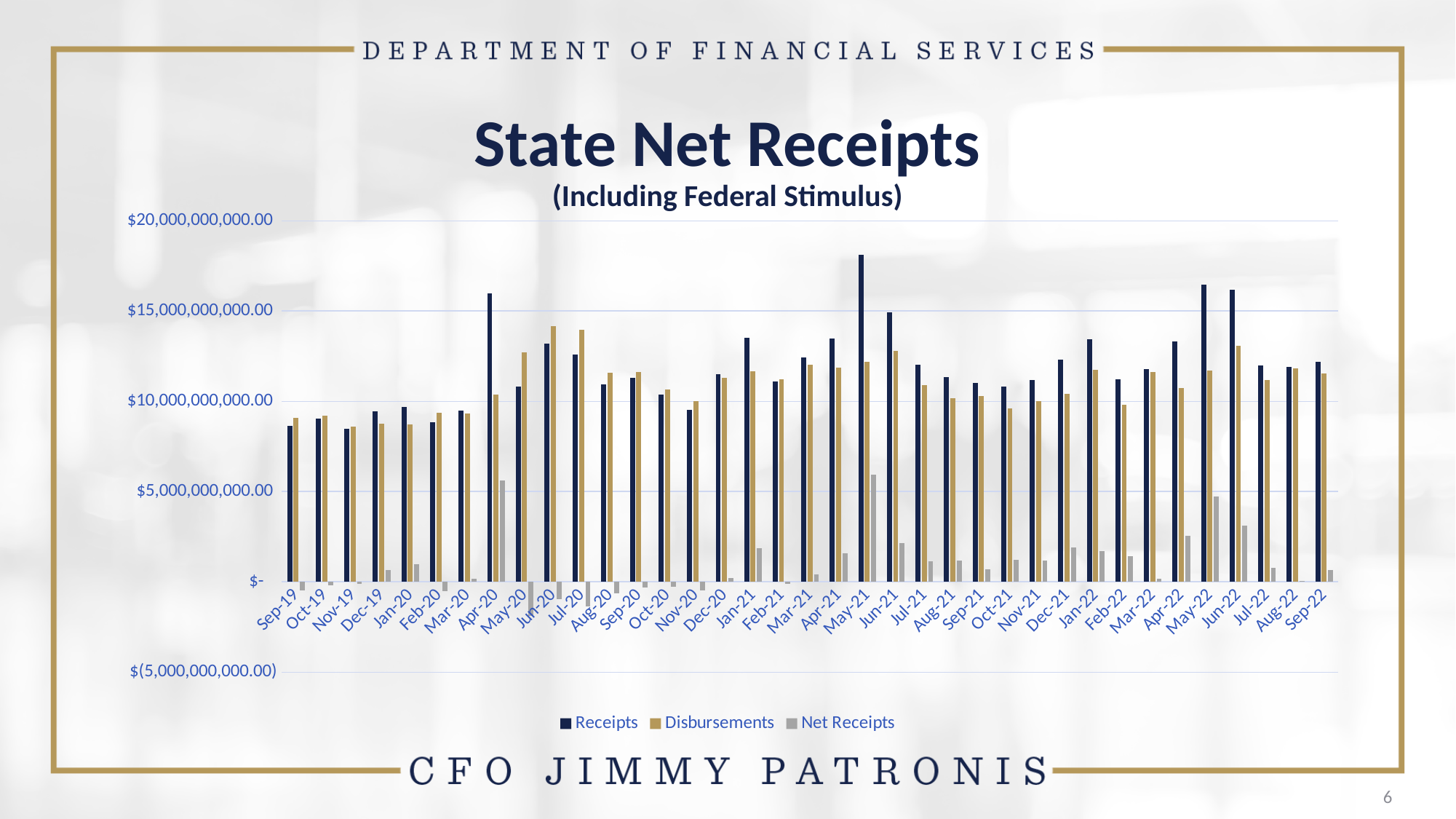
Is the Disbursements value for Oct-21 greater or less than $10,000,000,000.00? less What is the subtitle shown under the chart title 'State Net Receipts'? (Including Federal Stimulus) How many series does the legend list? 3 Is the Receipts value for May-21 greater or less than $15,000,000,000.00? greater What kind of chart is shown on the slide? Bar chart How many months are shown along the x axis? 37 In May-21, which is larger: Receipts or Disbursements? Receipts Is the Receipts value for Sep-19 greater or less than $10,000,000,000.00? less In Jun-20, which is larger: Receipts or Disbursements? Disbursements Which month has the highest Receipts value? May-21